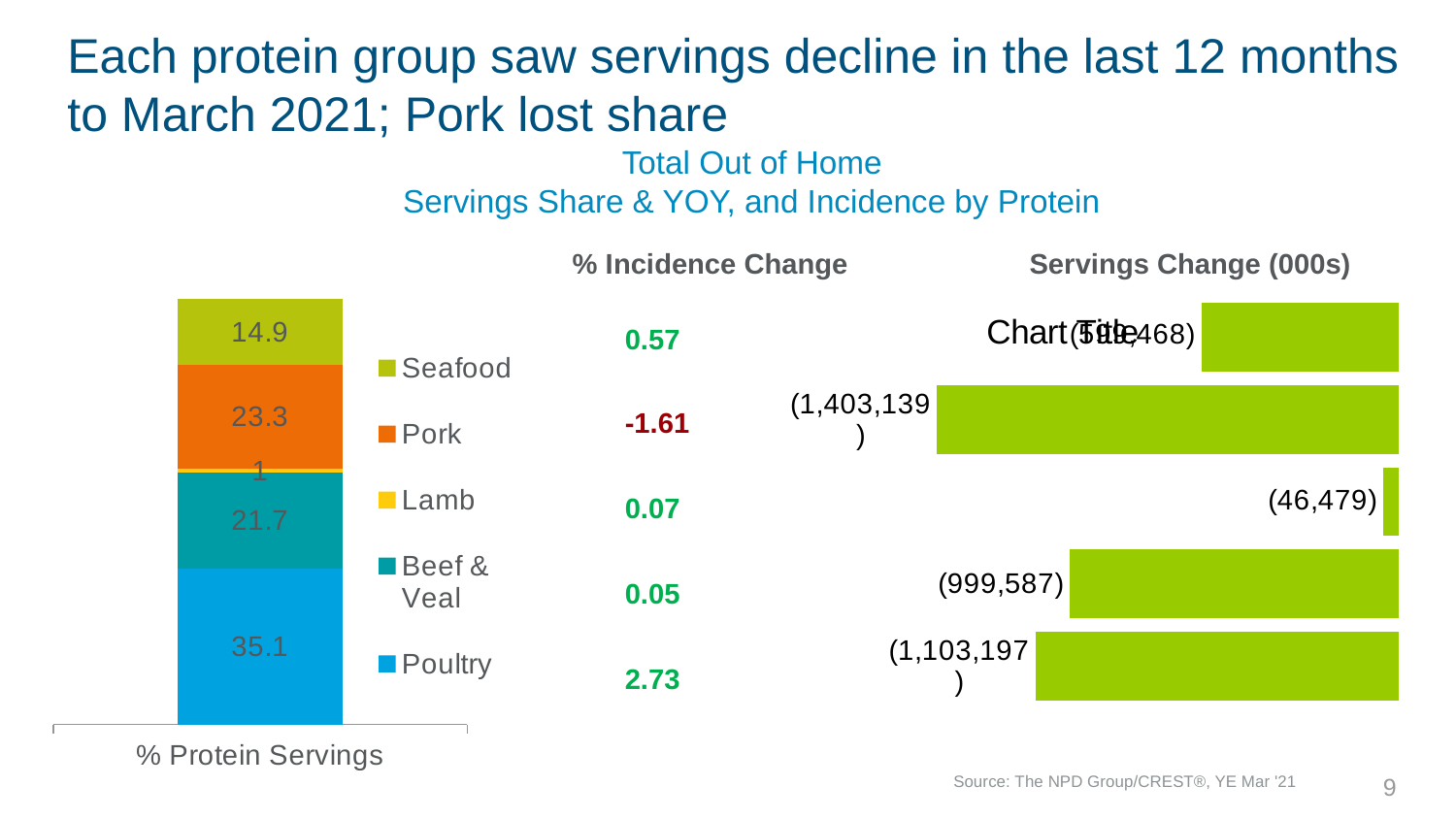
In the left '% Protein Servings' chart, which protein has the largest segment? Poultry In the left '% Protein Servings' chart, what is the value for Pork? 23.3 In the right 'Servings Change (000s)' chart, what is the value shown for Lamb? (46,479) In the left '% Protein Servings' chart, which is larger, Beef & Veal or Pork? Pork In the right 'Servings Change (000s)' chart, what is the value shown for Poultry? (1,103,197) In the right 'Servings Change (000s)' chart, what is the value shown for Pork? (1,403,139) What kind of chart is the left chart labelled '% Protein Servings'? stacked bar chart In the left '% Protein Servings' chart, what is the value for Poultry? 35.1 In the left '% Protein Servings' chart, what is the value for Seafood? 14.9 In the left '% Protein Servings' chart, how many protein segments make up the stacked bar? 5 In the left '% Protein Servings' chart, what is the difference between the Poultry and Pork values? 11.8 In the left '% Protein Servings' chart, which protein has the smallest segment? Lamb